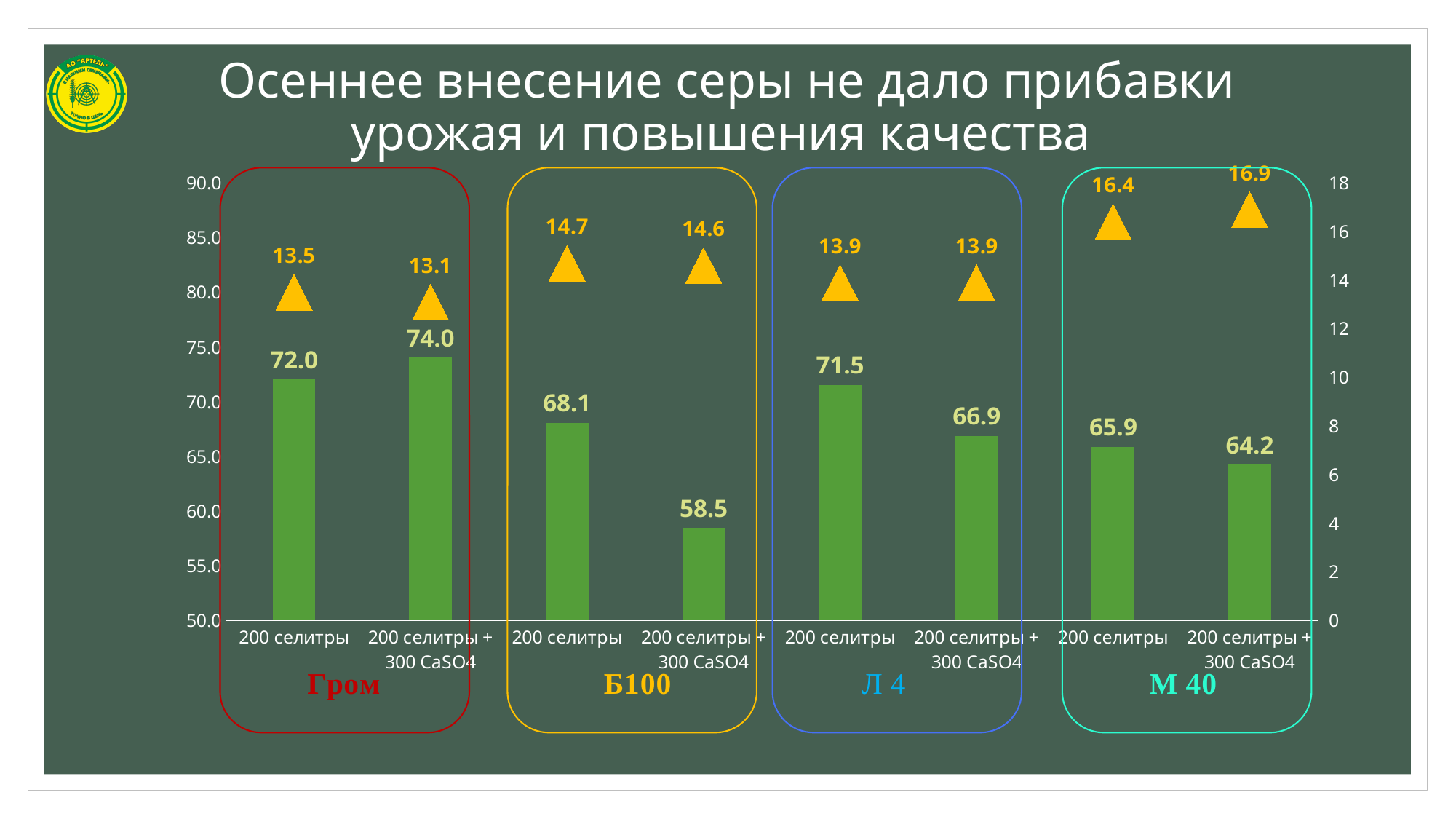
What is the bar value for "200 селитры" in the Гром group? 72.0 In the Л 4 group, which bar is larger: "200 селитры" or "200 селитры + 300 CaSO4"? 200 селитры What is the difference between the two bar values in the Б100 group (200 селитры minus 200 селитры + 300 CaSO4)? 9.6 Which group contains the highest bar value on the chart? Гром How many bars are plotted on the chart in total? 8 What type of chart is shown on the slide? Bar chart with triangle markers What is the triangle marker value for "200 селитры" in the Л 4 group? 13.9 What is the bar value for "200 селитры + 300 CaSO4" in the Б100 group? 58.5 What is the difference between the two bar values in the Гром group (200 селитры + 300 CaSO4 minus 200 селитры)? 2.0 What is the title of the slide? Осеннее внесение серы не дало прибавки урожая и повышения качества Which group contains the lowest bar value on the chart? Б100 What is the triangle marker value for "200 селитры + 300 CaSO4" in the М 40 group? 16.9